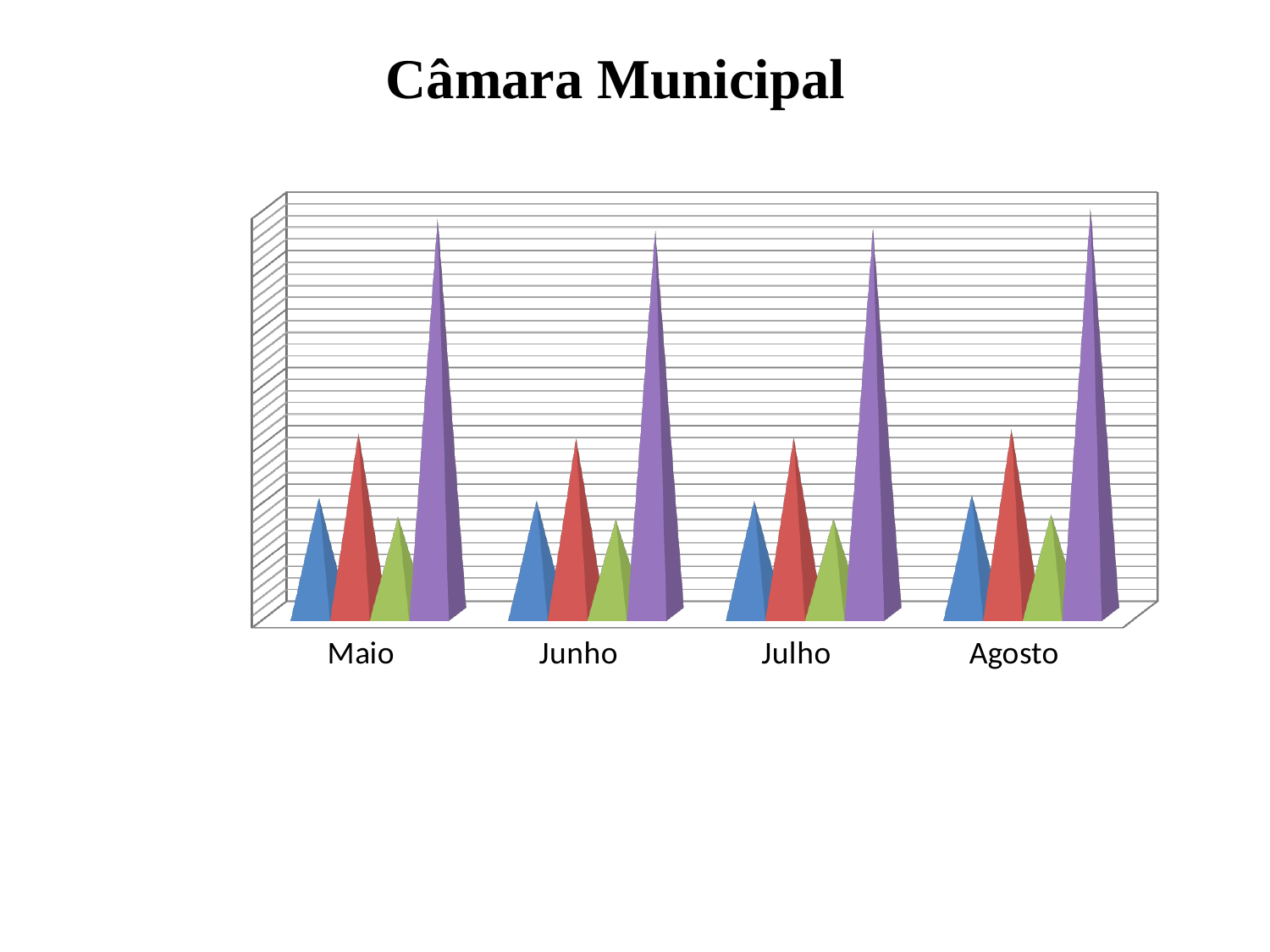
In Junho, which is taller: the purple bar or the red bar? purple In Maio, which is taller: the red bar or the blue bar? red What is the last category label on the x axis of the chart? Agosto How many bars are plotted for each month on the chart? 4 How many categories are shown on the x axis of the chart? 4 Which colour bar is the tallest in every month on the chart? purple In Agosto, which is taller: the blue bar or the purple bar? purple What kind of chart is shown on the slide? bar chart What is the title of the slide containing the chart? Câmara Municipal What is the first category label on the x axis of the chart? Maio